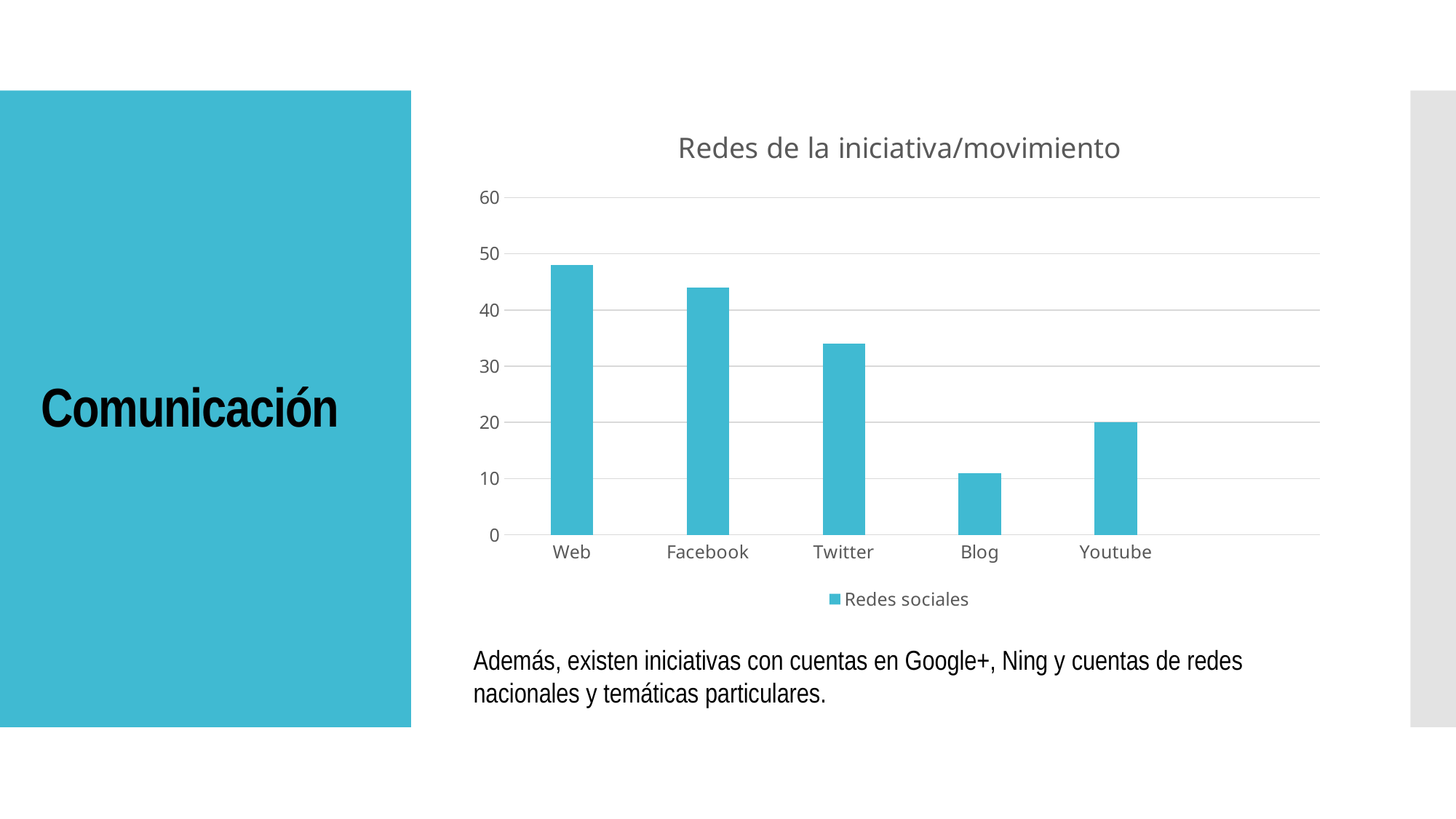
What is the title of the chart? Redes de la iniciativa/movimiento What is the name of the series shown in the legend? Redes sociales Which is larger, the value for Facebook or the value for Twitter? Facebook Which is larger, the value for Youtube or the value for Blog? Youtube Is the value for Web greater or less than 40? greater Which category has the lowest value in the chart? Blog Is the value for Twitter greater or less than 30? greater How many series does the chart legend list? 1 Which category has the highest value in the chart? Web Is the value for Blog greater or less than 20? less What kind of chart is shown on the slide? bar chart How many categories are shown on the x axis of the chart? 5